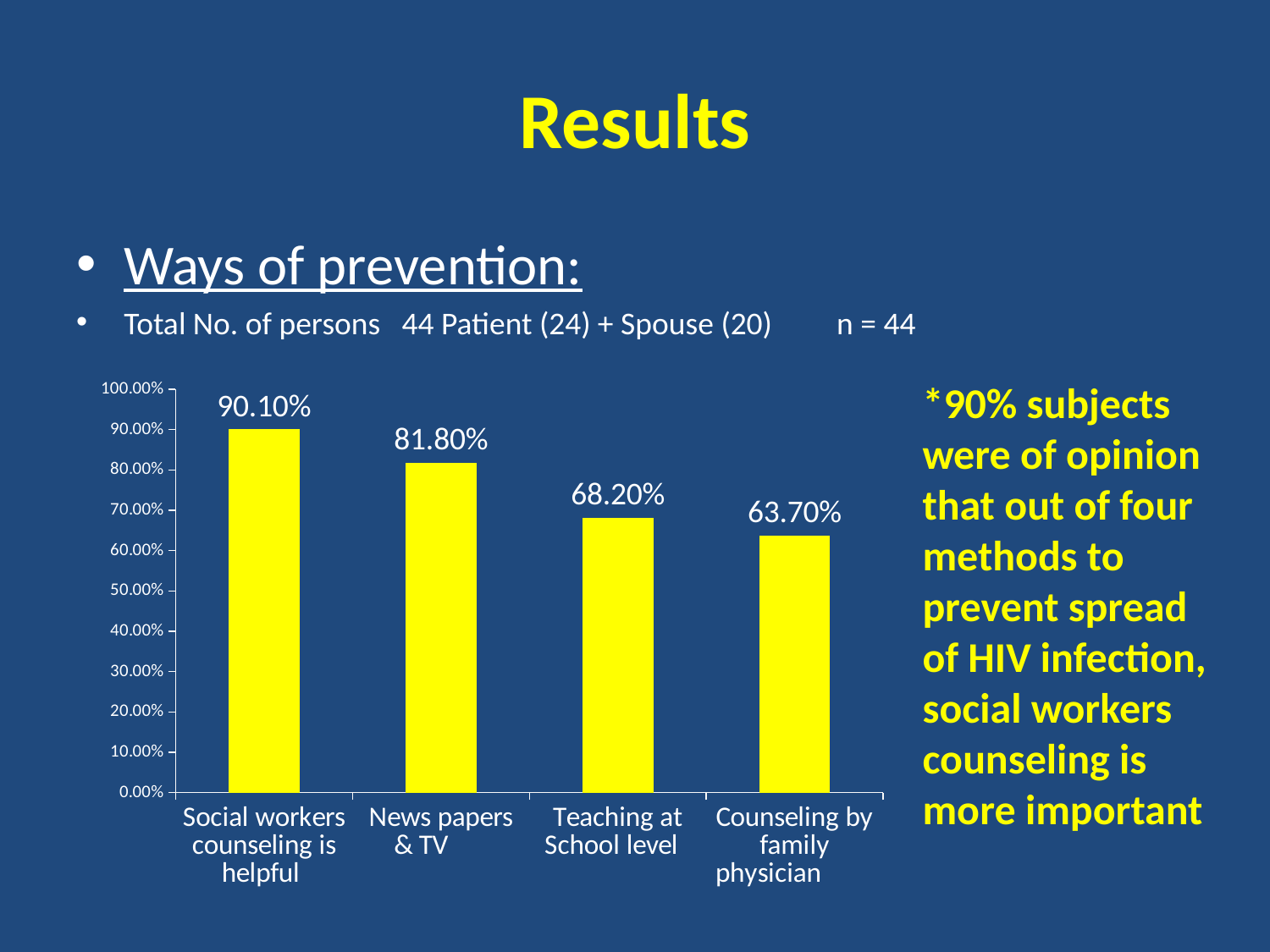
How many categories are shown in the chart? 4 What is the value for News papers & TV? 81.80% Which category has the lowest value? Counseling by family physician What is the value for Counseling by family physician? 63.70% What is the value for Social workers counseling is helpful? 90.10% Which is larger, the value for News papers & TV or the value for Teaching at School level? News papers & TV What is the difference between the values for Teaching at School level and Counseling by family physician? 4.50% What is the difference between the values for Social workers counseling is helpful and News papers & TV? 8.30% What kind of chart is shown on the slide? Bar chart What is the value for Teaching at School level? 68.20% Do the values rise or fall from left to right along the x axis? Fall Which category has the highest value? Social workers counseling is helpful